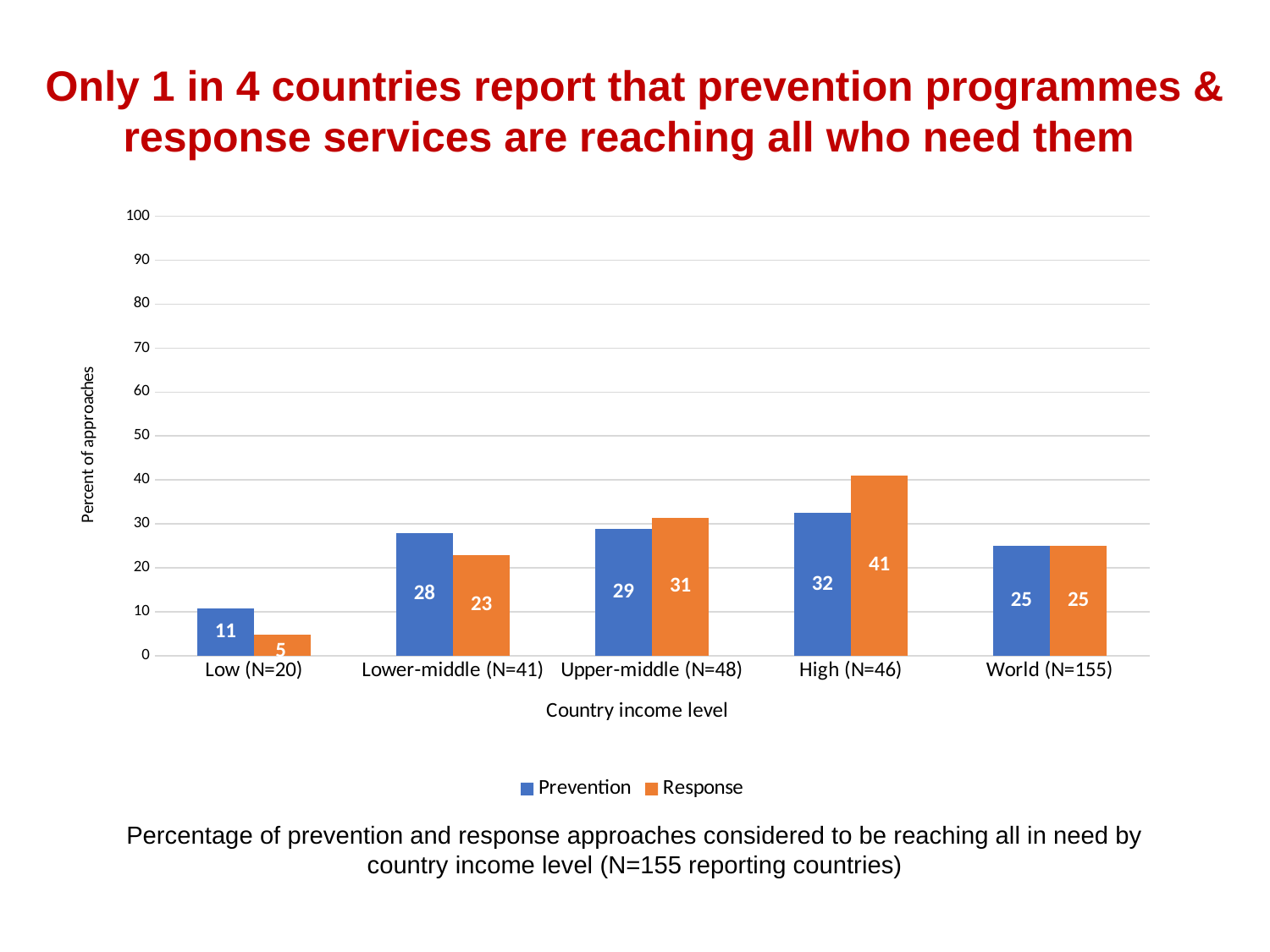
Which is larger for Lower-middle (N=41): the Prevention value or the Response value? Prevention What is the label of the y axis? Percent of approaches How many country income level categories are shown on the x axis? 5 What kind of chart is shown on the slide? bar chart What is the Response value for High (N=46)? 41 What is the Response value for Lower-middle (N=41)? 23 What is the difference between the Response and Prevention values for High (N=46)? 9 Is the Response value for Upper-middle (N=48) greater or less than 40? less How many series does the legend list? 2 Which country income level has the highest Response value? High (N=46) Which country income level has the lowest Prevention value? Low (N=20) What is the Prevention value for Low (N=20)? 11